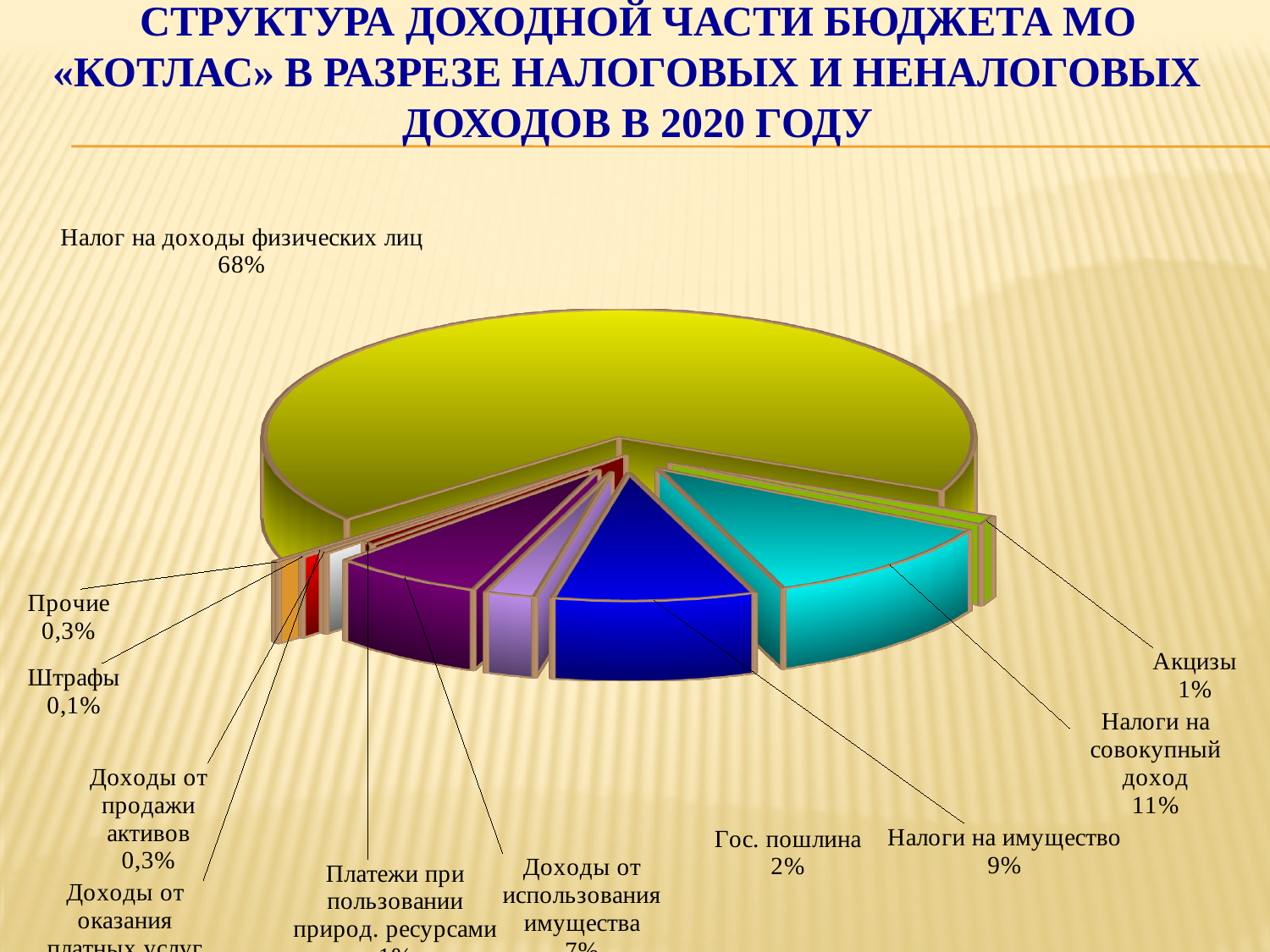
What is the value shown for Налоги на совокупный доход? 11% Which is larger, the share for Гос. пошлина or the share for Акцизы? Гос. пошлина Which year does the chart title say the budget revenue structure refers to? 2020 What is the difference between the shares of Налоги на совокупный доход and Налоги на имущество? 2% What share of the budget revenue is Налог на доходы физических лиц? 68% What is the value shown for Налоги на имущество? 9% What kind of chart is shown on the slide? pie chart What is the value shown for Гос. пошлина? 2% What is the value shown for Акцизы? 1% What is the value shown for Штрафы? 0,1% Which category has the largest share of the pie? Налог на доходы физических лиц